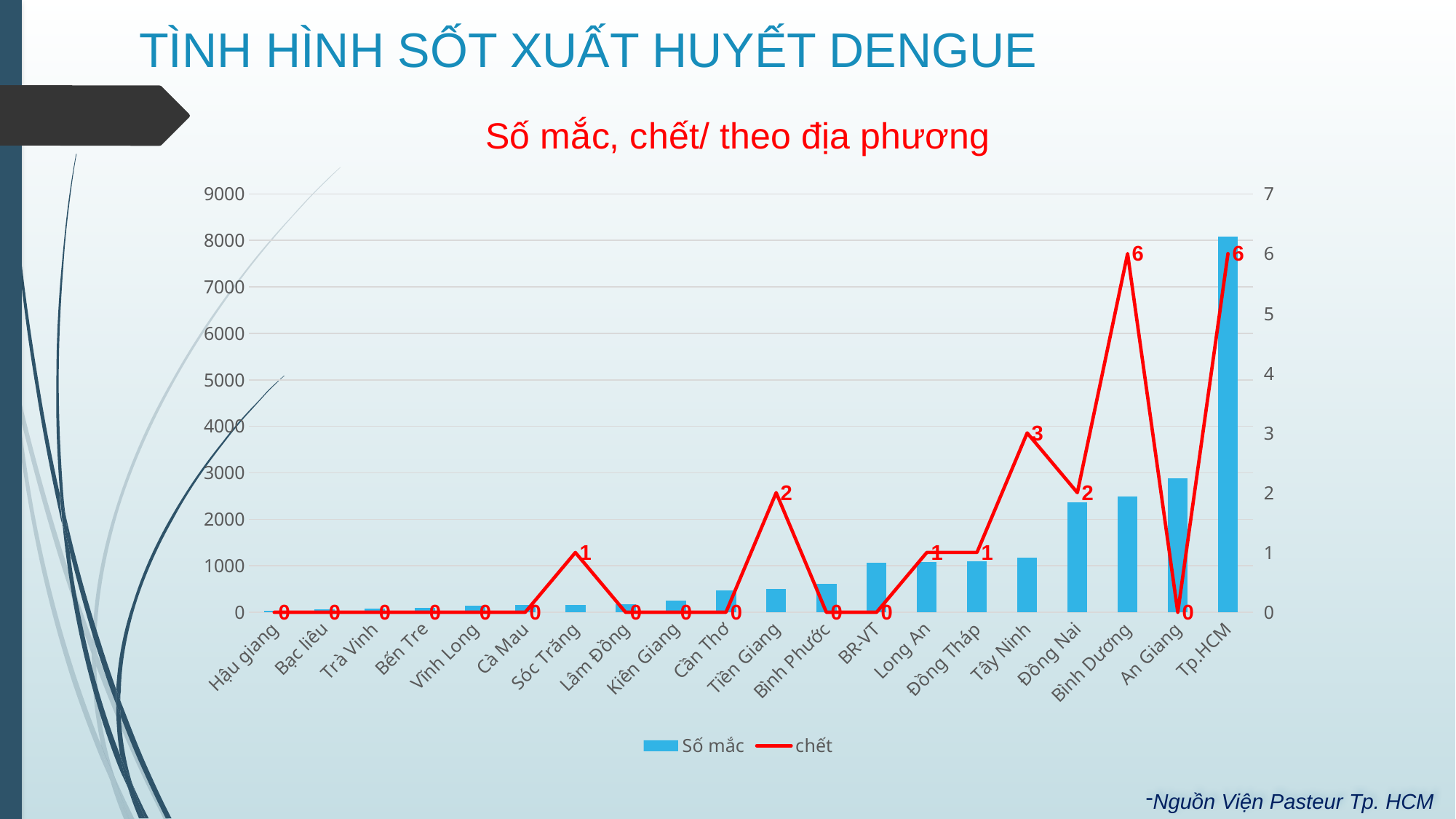
What is the value of 'chết' for Tiền Giang? 2 How many provinces (categories) are shown on the x axis? 20 What is the value of 'chết' for Bình Dương? 6 Is the 'Số mắc' value for Tp.HCM greater or less than 7000? greater How many series does the legend list? 2 What is the difference in 'chết' between Bình Dương and Tây Ninh? 3 What is the value of 'chết' for Tây Ninh? 3 Which has a larger 'chết' value, Đồng Nai or Sóc Trăng? Đồng Nai Is the 'Số mắc' value for Bình Dương greater or less than 2000? greater What is the value of 'chết' for An Giang? 0 What type of chart is shown on the slide? Combination bar and line chart Which province has the highest 'Số mắc' bar? Tp.HCM